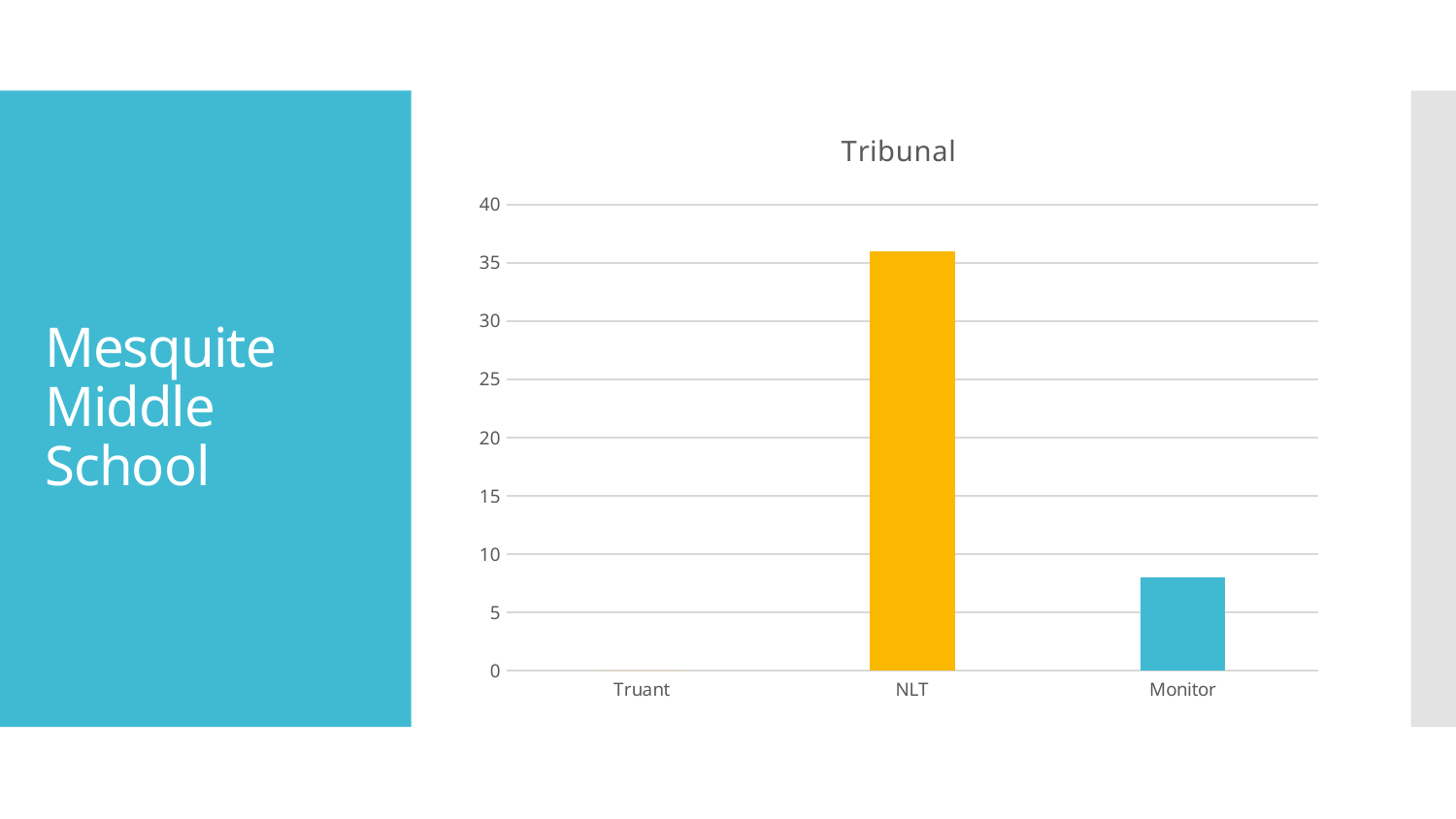
How many categories are shown on the x axis of the Tribunal chart? 3 Is the value for Monitor greater or less than 5? greater Is the value for Monitor greater or less than 10? less What kind of chart is shown on the slide? bar chart Which category has the highest value in the Tribunal chart? NLT What is the title of the chart? Tribunal Is the value for NLT greater or less than 30? greater Which is larger in the Tribunal chart, the value for Monitor or the value for Truant? Monitor What colour is the NLT bar in the Tribunal chart? yellow Which is larger in the Tribunal chart, the value for NLT or the value for Monitor? NLT Which category has the lowest value in the Tribunal chart? Truant